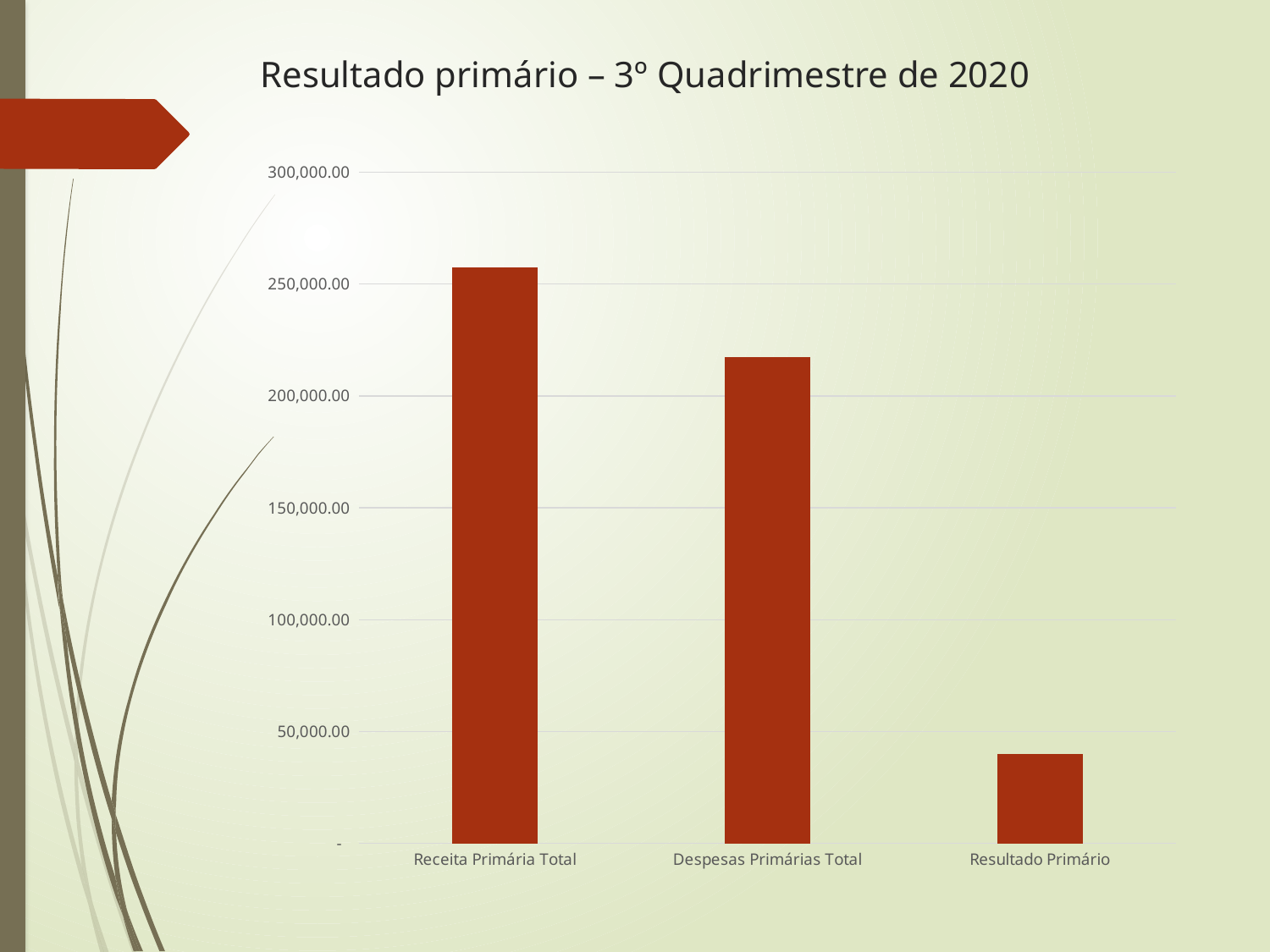
Which category has the lowest value? Resultado Primário Is the value for Despesas Primárias Total greater or less than 250,000.00? less Is the value for Despesas Primárias Total greater or less than 200,000.00? greater Which category has the highest value? Receita Primária Total Is the value for Resultado Primário greater or less than 50,000.00? less How many categories are plotted on the chart? 3 Do the bar values rise or fall from left to right across the categories? fall What kind of chart is shown on the slide? bar chart Which is larger, Receita Primária Total or Despesas Primárias Total? Receita Primária Total What is the title of the slide containing the chart? Resultado primário – 3º Quadrimestre de 2020 Which is larger, Despesas Primárias Total or Resultado Primário? Despesas Primárias Total